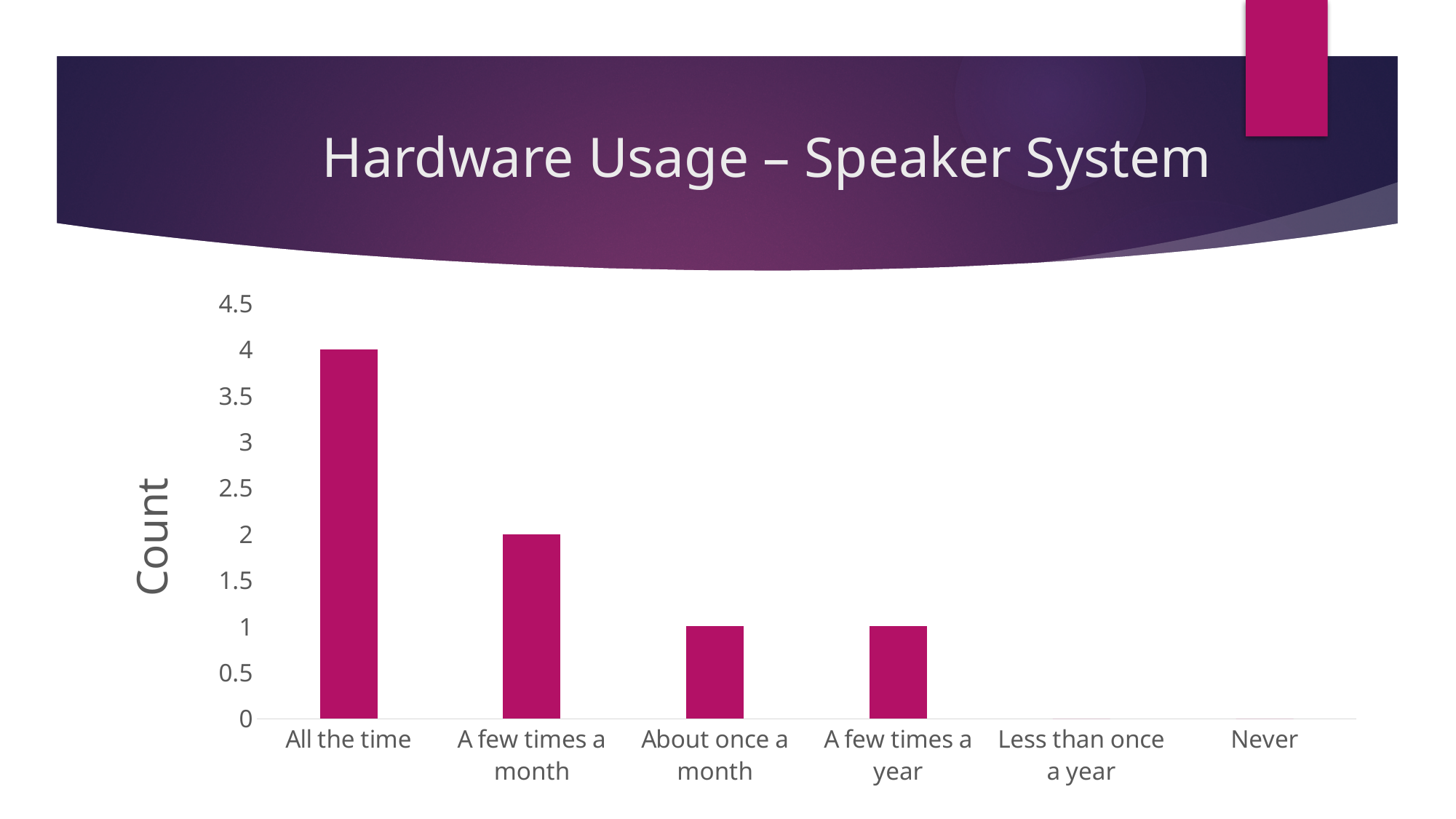
How many categories are shown on the x axis? 6 What is the difference between the counts for "All the time" and "A few times a month"? 2 What is the count for "All the time"? 4 What kind of chart is shown on the slide? Bar chart What is the count for "A few times a year"? 1 Is the count for "All the time" greater or less than 3? greater Which has a larger count, "A few times a month" or "About once a month"? A few times a month Which category has the highest count? All the time Do the counts generally rise or fall from left to right across the categories? Fall What is the count for "About once a month"? 1 What is the count for "A few times a month"? 2 What is the label of the vertical axis? Count